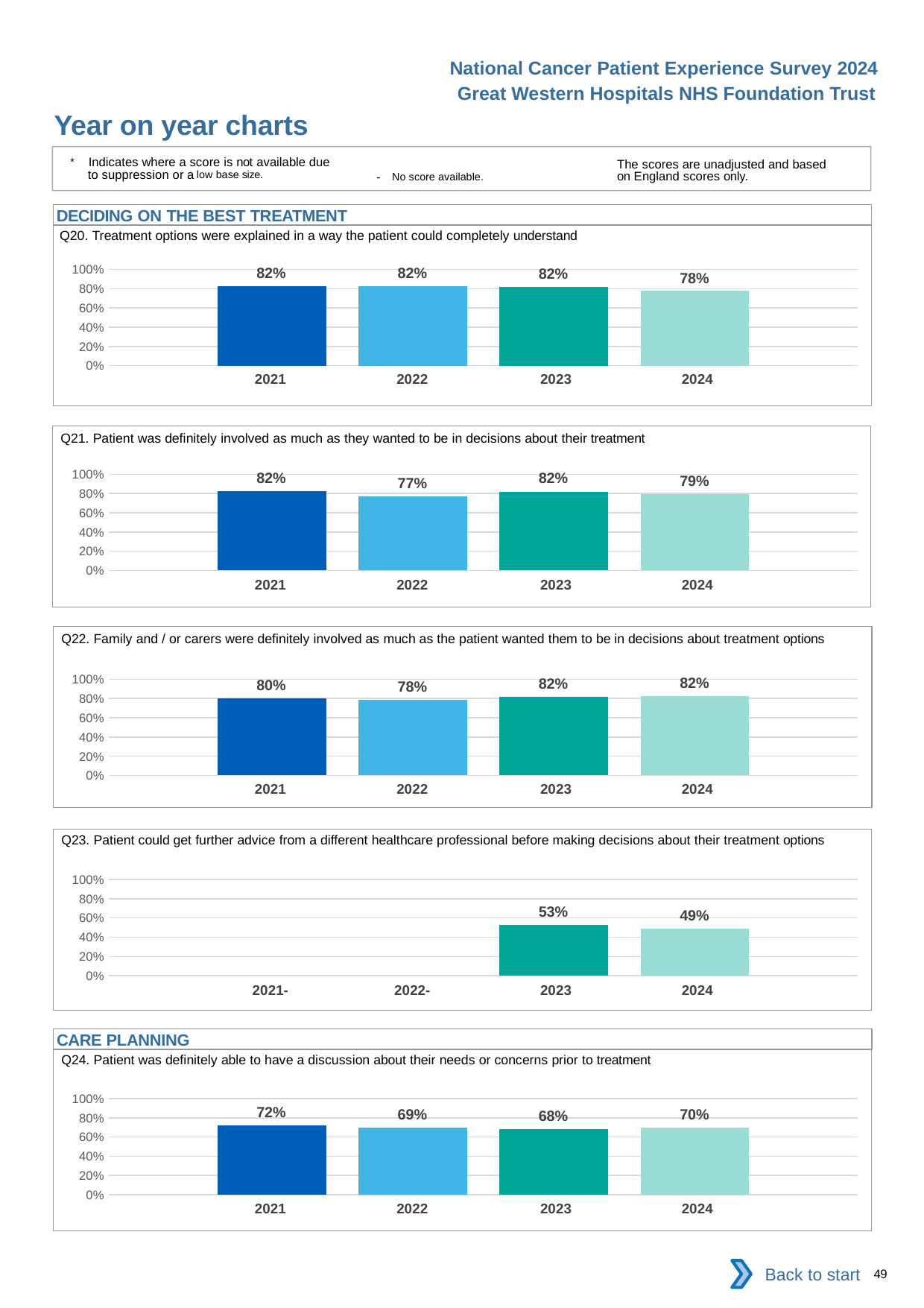
What kind of chart is the Q20 chart? bar chart In the Q22 chart, what is the value for 2021? 80% In the Q24 chart, which year has the highest value? 2021 In the Q23 chart, how many years have a bar plotted? 2 In the Q24 chart, what is the difference between the 2021 and 2023 values? 4% In the Q23 chart, what is the value for 2023? 53% In the Q21 chart, what is the difference between the 2021 and 2022 values? 5% In the Q21 chart, which year has the lowest value? 2022 In the Q22 chart, is the value for 2022 larger or smaller than the value for 2023? smaller In the Q23 chart, is the value for 2024 greater or less than 60%? less In the Q20 chart, what is the value for 2024? 78% In the Q24 chart, what is the value for 2022? 69%